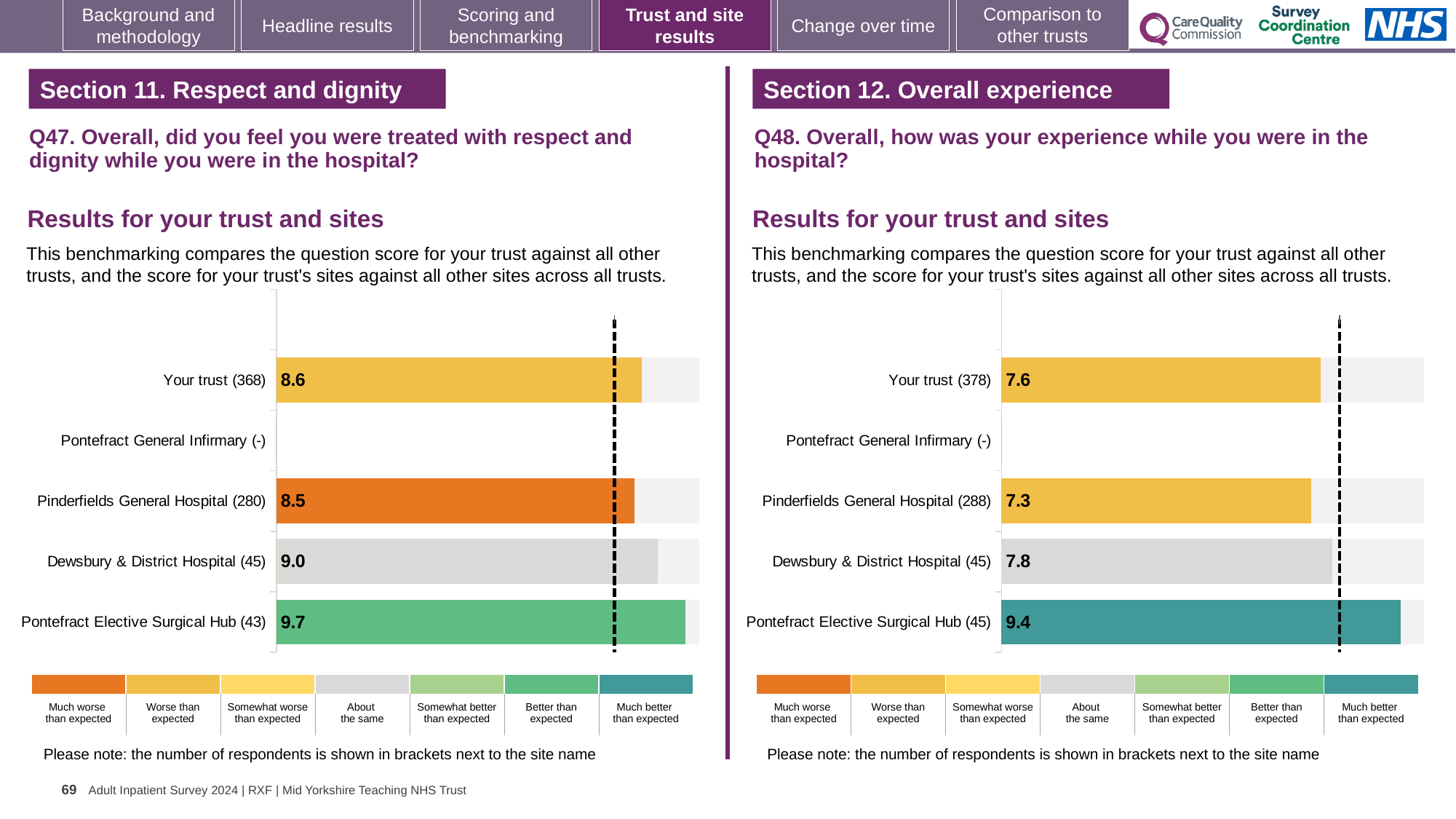
On the Q48 chart (right), which site with a score shown has the lowest score? Pinderfields General Hospital On the Q48 chart (right), what is the score for Pontefract Elective Surgical Hub? 9.4 On the Q47 chart (left), which has the larger score: Dewsbury & District Hospital or Your trust? Dewsbury & District Hospital On the Q48 chart (right), what is the difference between the scores for Dewsbury & District Hospital and Your trust? 0.2 On the Q48 chart (right), which has the larger score: Your trust or Pinderfields General Hospital? Your trust On the Q47 chart (left), what is the score for Your trust? 8.6 How many site/trust categories are listed on the Q48 chart (right)? 5 On the Q47 chart (left), what is the difference between the scores for Pontefract Elective Surgical Hub and Pinderfields General Hospital? 1.2 What kind of chart is used on the Q47 chart (left)? Bar chart On the Q47 chart (left), which benchmark category does the colour of the Pinderfields General Hospital bar correspond to? Much worse than expected On the Q47 chart (left), how many respondents are shown for Pinderfields General Hospital? 280 On the Q47 chart (left), which site has the highest score? Pontefract Elective Surgical Hub